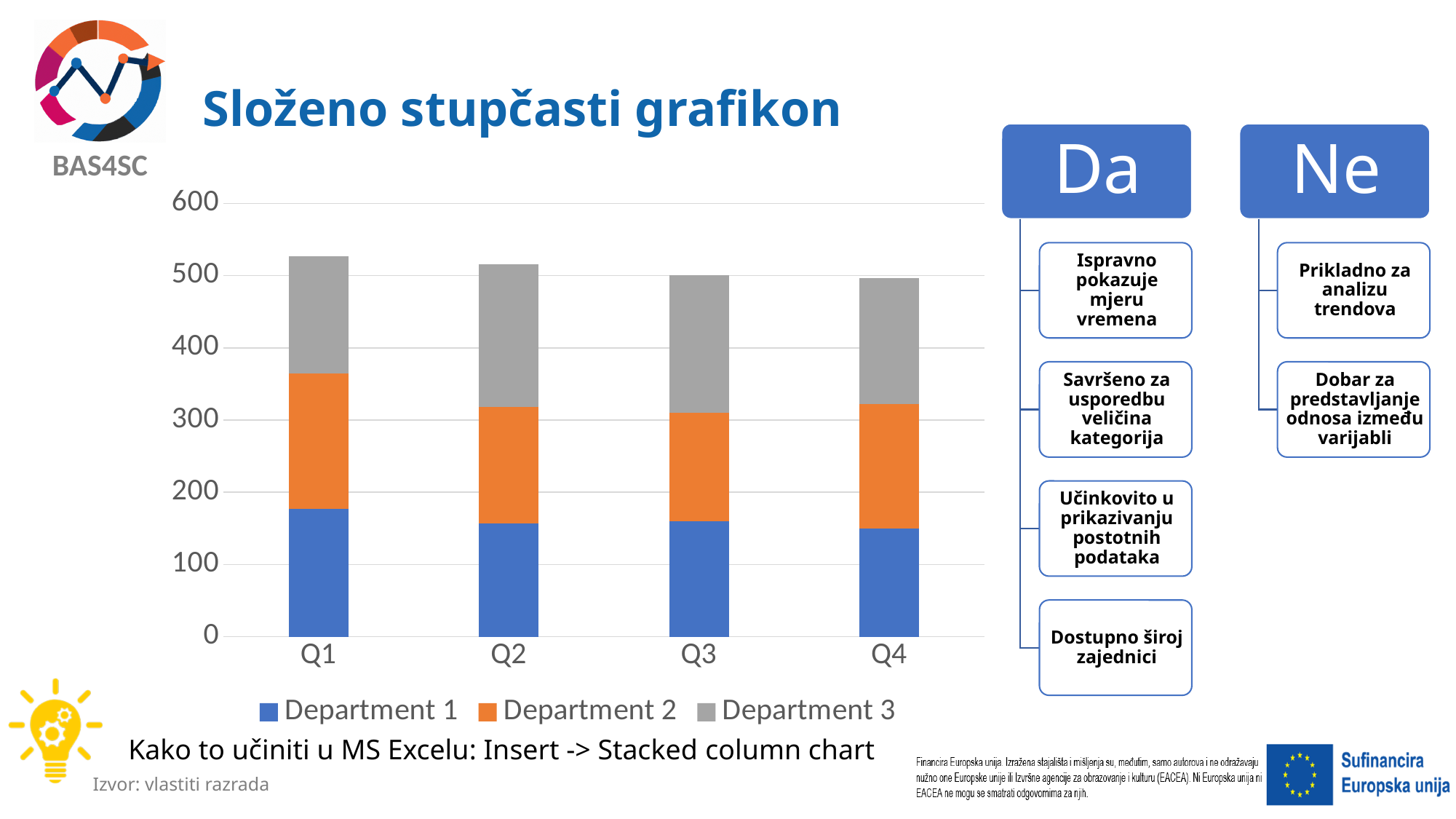
Is the value for Department 1 in Q4 greater or less than 100? greater Is the total height of the stacked bar for Q2 greater or less than 400? greater What kind of chart is shown on the slide? Stacked bar chart Is the value for Department 1 in Q1 greater or less than 200? less How many series does the chart's legend list? 3 What are the three series named in the chart's legend? Department 1, Department 2, Department 3 Which is larger, the total stacked bar for Q1 or for Q4? Q1 Do the total heights of the stacked bars rise or fall from Q1 to Q4? fall Which quarter has the highest value for Department 1? Q1 What is the title of the chart on the slide? Složeno stupčasti grafikon How many quarters (categories) are shown on the x axis of the chart? 4